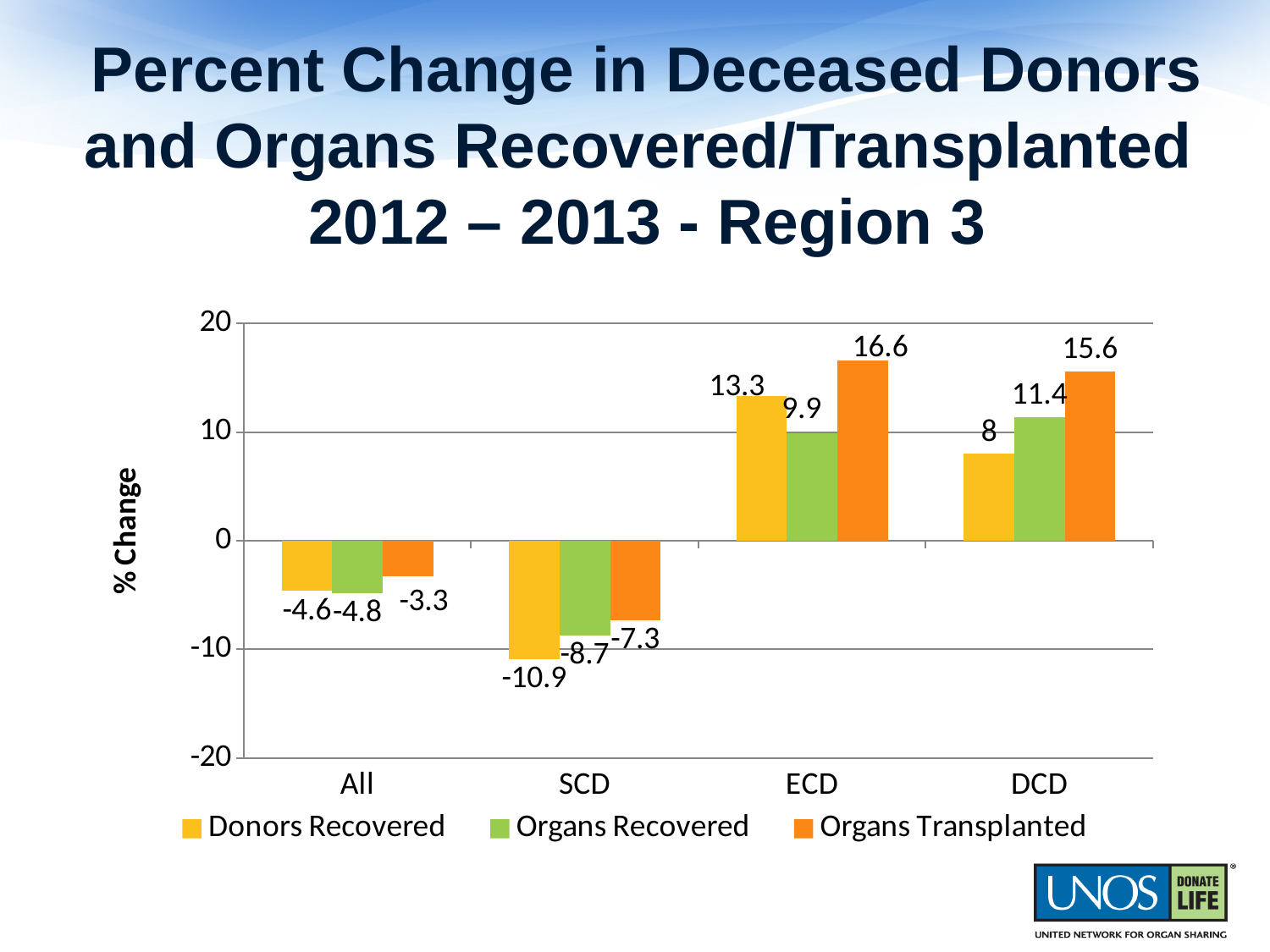
How many categories are shown on the x axis? 4 Which is larger: Organs Recovered for ECD or Organs Recovered for DCD? Organs Recovered for DCD How many series does the legend list? 3 What is the value for Organs Recovered in the DCD category? 11.4 What is the difference between Organs Transplanted for ECD and DCD? 1 Which category has the highest Organs Transplanted value? ECD Which category has the lowest Donors Recovered value? SCD What is the value for Organs Transplanted in the SCD category? -7.3 What is the value for Donors Recovered in the ECD category? 13.3 What kind of chart is shown on the slide? Bar chart What is the label of the y axis? % Change What is the value for Donors Recovered in the All category? -4.6